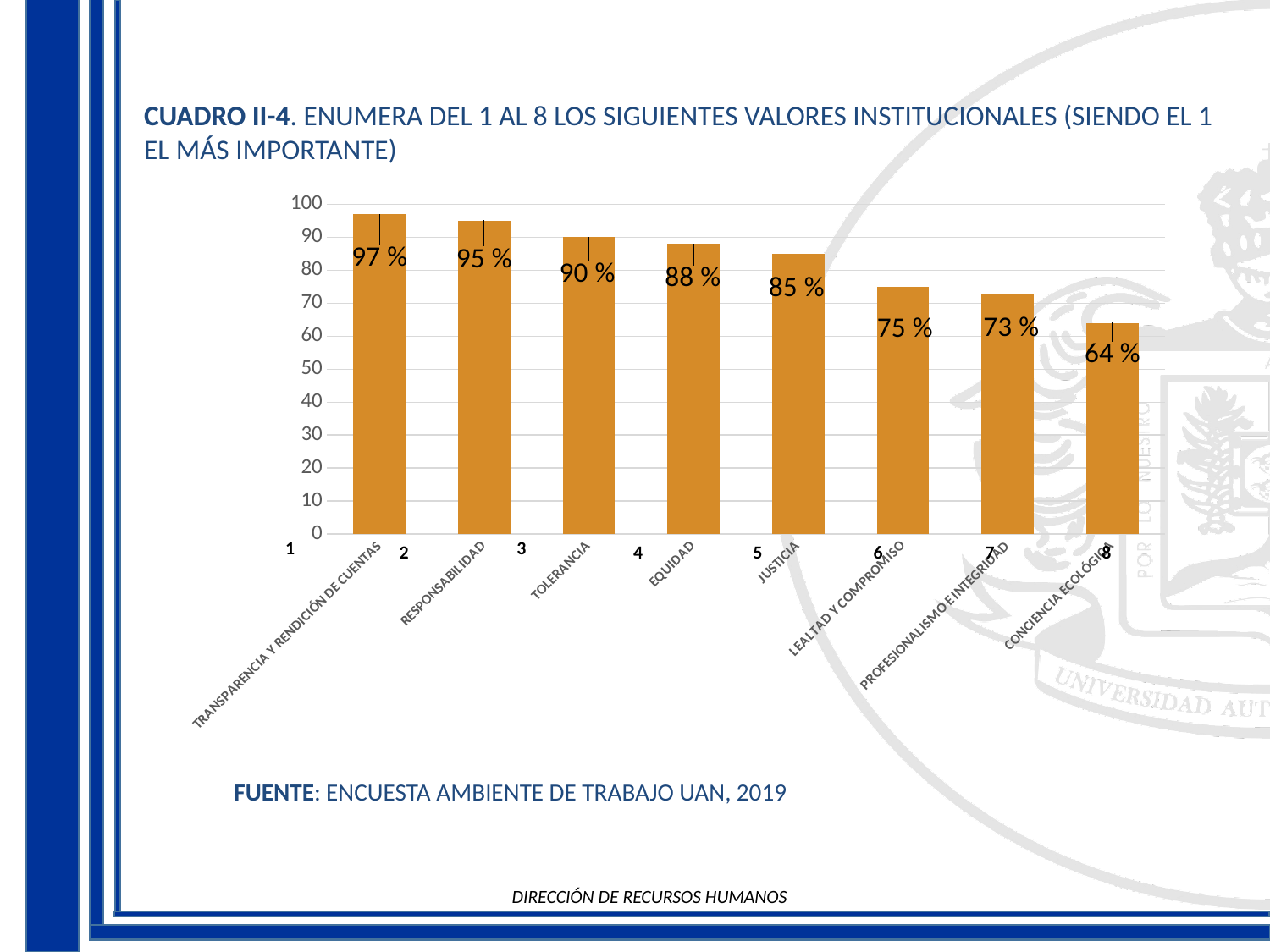
Which is larger, the value for EQUIDAD or the value for LEALTAD Y COMPROMISO? EQUIDAD Is the value for JUSTICIA greater or less than 80? greater Do the values rise or fall from left to right along the x axis? fall What is the value for LEALTAD Y COMPROMISO? 75 % What is the value for CONCIENCIA ECOLÓGICA? 64 % What is the difference between the values for RESPONSABILIDAD and JUSTICIA? 10 % Which category has the highest value? TRANSPARENCIA Y RENDICIÓN DE CUENTAS What kind of chart is shown on the slide? bar chart Which category has the lowest value? CONCIENCIA ECOLÓGICA What is the difference between the values for EQUIDAD and PROFESIONALISMO E INTEGRIDAD? 15 % What is the value for TOLERANCIA? 90 % How many categories are shown in the chart? 8